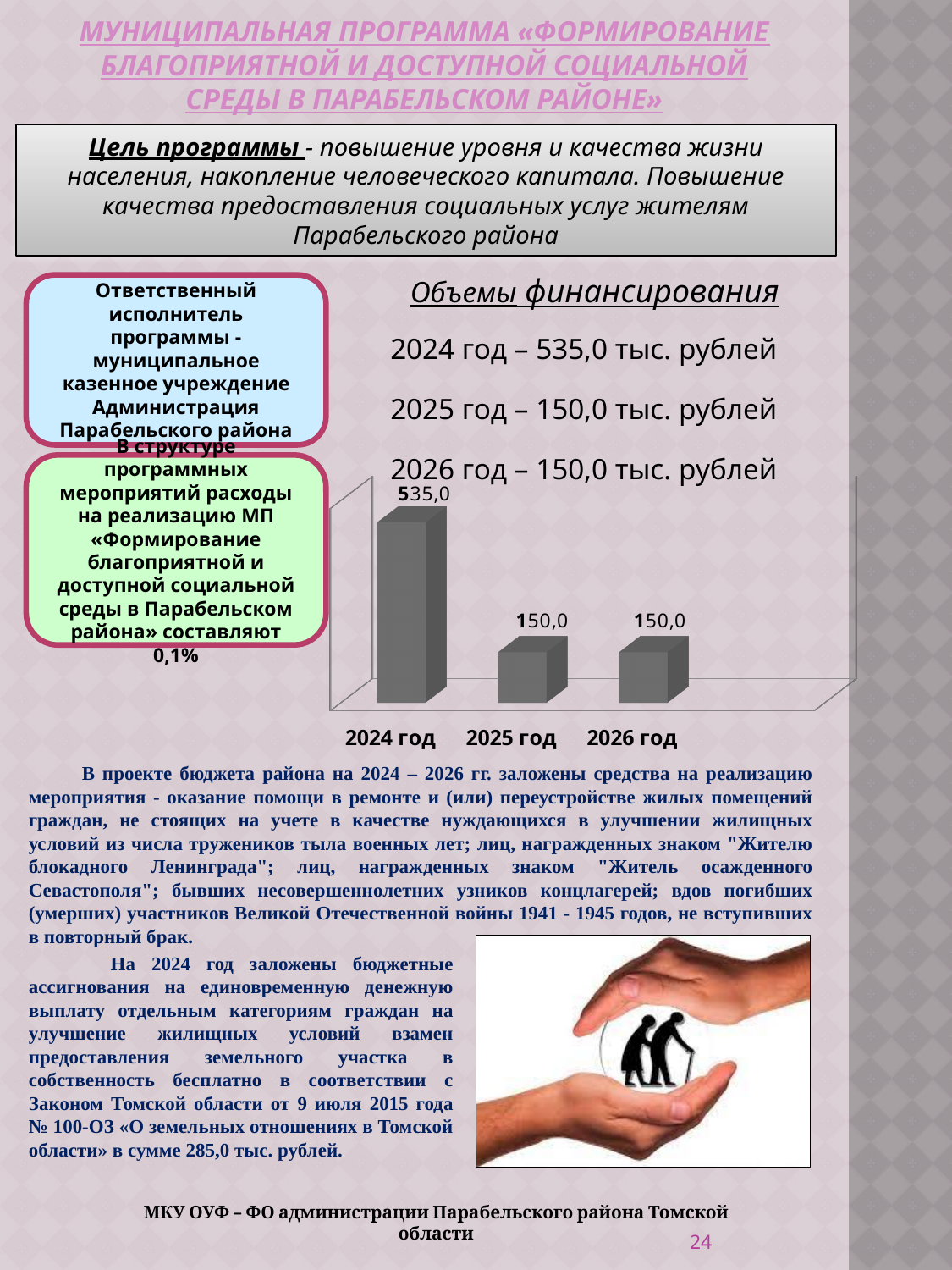
What is the value shown for 2024 год in the chart? 535,0 What colour are the bars in the chart? grey Which year has the highest value in the chart? 2024 год What is the value shown for 2026 год in the chart? 150,0 Do the values rise or fall from 2024 год to 2025 год? fall Which is larger, the value for 2024 год or the value for 2026 год? 2024 год What is the total of the values for all three years in the chart? 835,0 What is the value shown for 2025 год in the chart? 150,0 How many categories (years) are plotted in the chart? 3 What is the difference between the values for 2025 год and 2026 год? 0,0 What is the difference between the values for 2024 год and 2025 год? 385,0 What kind of chart is shown on the slide? bar chart